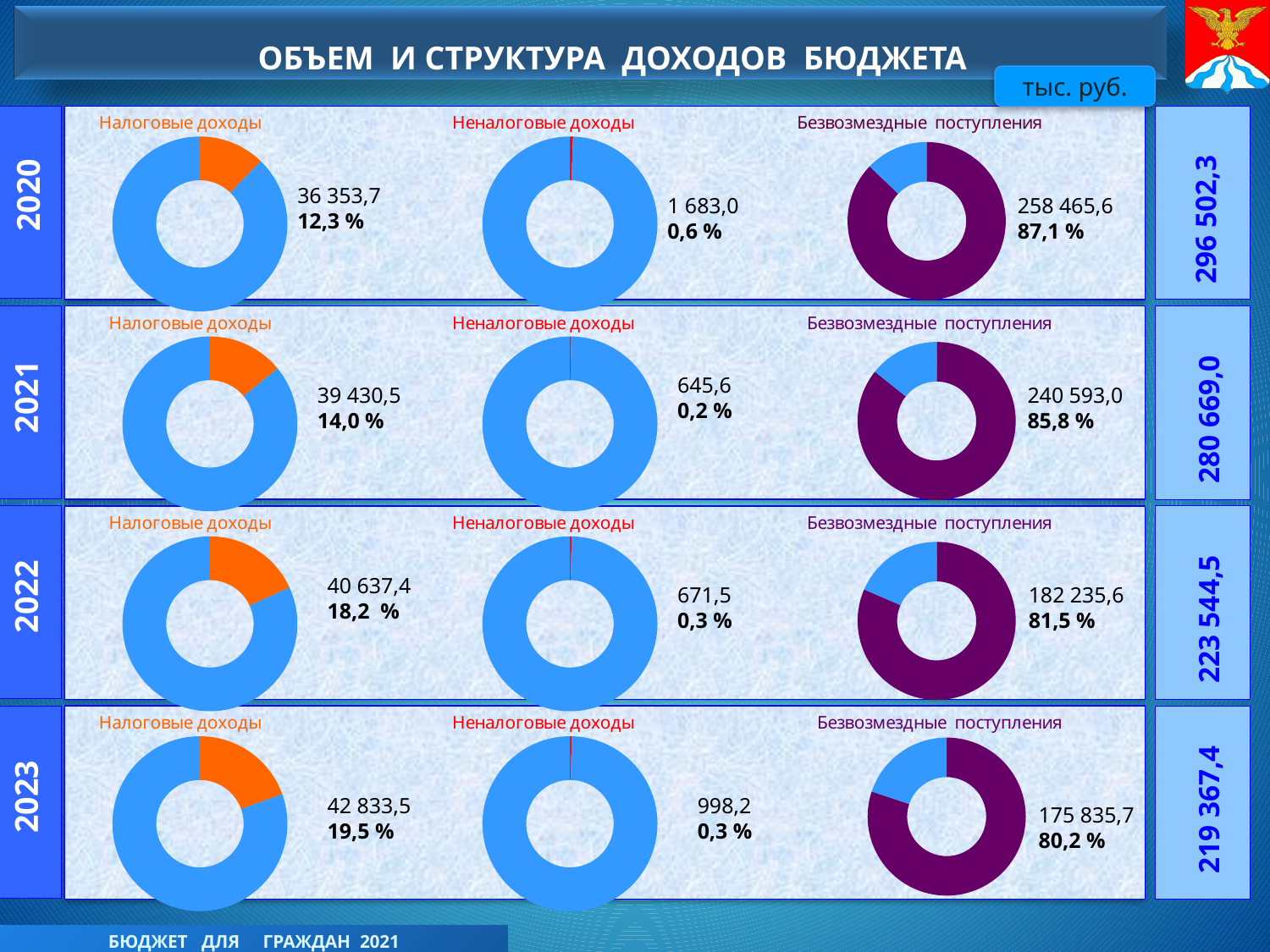
Across the four Налоговые доходы donut charts, which year shows the highest value? 2023 In the 2023 row, what share of the budget revenue does the Налоговые доходы donut chart show? 19,5 % Which is larger: the Безвозмездные поступления value for 2020 or for 2022? 2020 In the 2023 row, what value is shown on the Безвозмездные поступления donut chart? 175 835,7 In the 2020 row, what value is shown on the Налоговые доходы donut chart? 36 353,7 What type of chart is used to show the revenue structure on this slide? donut (pie) chart In the 2021 row, what value is shown on the Неналоговые доходы donut chart? 645,6 Looking at the Безвозмездные поступления donut charts from 2020 to 2023, does the percentage rise or fall over the years? fall In the 2020 row, what percentage is shown on the Безвозмездные поступления donut chart? 87,1 % What is the difference between the Налоговые доходы values shown for 2021 and 2020? 3 076,8 In the 2022 row, what percentage is shown on the Налоговые доходы donut chart? 18,2 % Across the four Неналоговые доходы donut charts, which year shows the lowest value? 2021